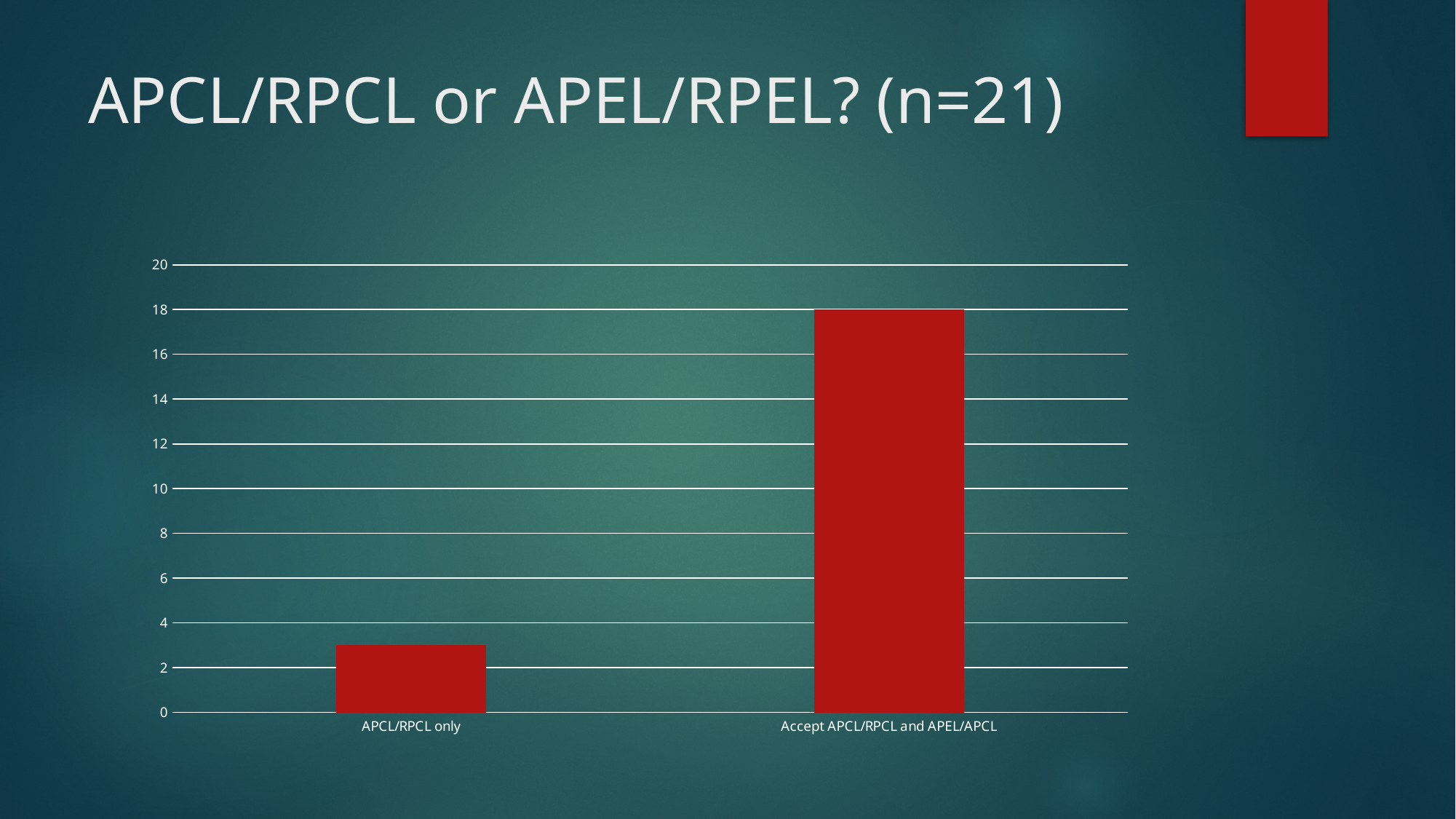
How many categories are plotted in the chart? 2 Which is larger, the value for APCL/RPCL only or the value for Accept APCL/RPCL and APEL/APCL? Accept APCL/RPCL and APEL/APCL Is the value for APCL/RPCL only greater or less than 4? less Which category has the highest value? Accept APCL/RPCL and APEL/APCL Is the value for APCL/RPCL only greater or less than 2? greater What is the value for Accept APCL/RPCL and APEL/APCL? 18 Is the value for Accept APCL/RPCL and APEL/APCL greater or less than 10? greater What is the title of the slide containing the chart? APCL/RPCL or APEL/RPEL? (n=21) Which category has the lowest value? APCL/RPCL only What is the highest value shown on the vertical axis of the chart? 20 What kind of chart is shown on the slide? bar chart